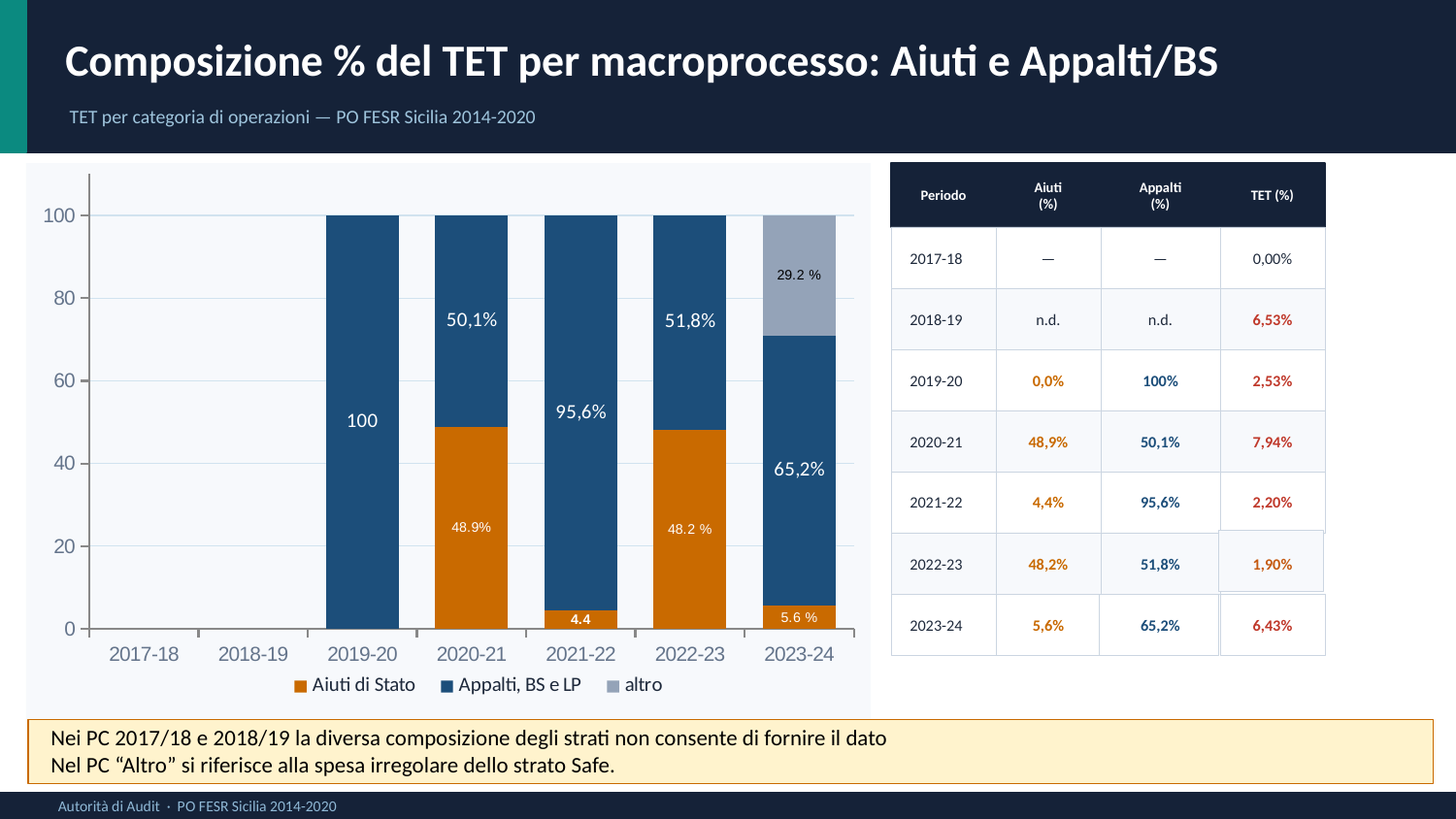
In which period is the Aiuti di Stato share the highest? 2020-21 In which period is the Appalti, BS e LP share the lowest among the periods with data? 2023-24 What is the value labelled for Aiuti di Stato in 2021-22? 4.4 What kind of chart is shown on the slide? stacked bar chart What is the value labelled for Appalti, BS e LP in 2020-21? 50,1% Which is larger in 2022-23: Aiuti di Stato or Appalti, BS e LP? Appalti, BS e LP What is the value labelled for Appalti, BS e LP in 2019-20? 100 How many series does the chart legend list? 3 What is the value labelled for altro in 2023-24? 29.2 % Which series is shown in orange in the chart legend? Aiuti di Stato Is the Appalti, BS e LP value for 2023-24 greater or less than 60? greater How many periods are shown on the x axis of the chart? 7